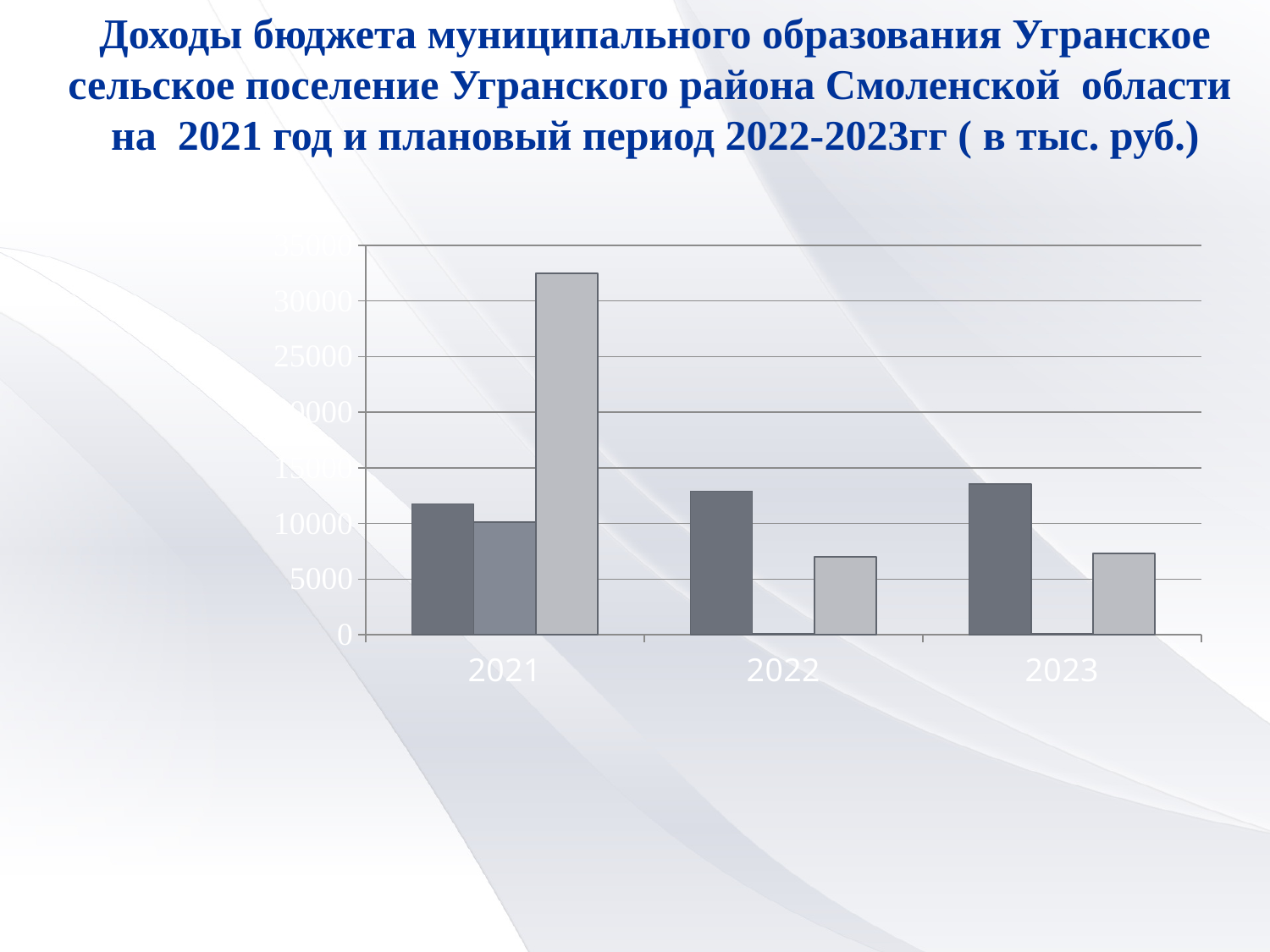
What kind of chart is shown on the slide? bar chart How many year categories are shown on the x axis of the chart? 3 Is the value of the first (dark grey) bar for 2021 greater or less than 10000? greater Which is larger for 2021: the first (dark grey) bar or the third (light grey) bar? the third (light grey) bar Is the value of the tallest bar for 2021 greater or less than 30000? greater Do the values of the first (dark grey) bars rise or fall from 2021 to 2023? rise Is the value of the third (light grey) bar for 2023 greater or less than 10000? less Which is larger for 2022: the first (dark grey) bar or the third (light grey) bar? the first (dark grey) bar In what units are the values in the chart expressed, according to the slide title? тыс. руб. Which year has the tallest bar in the chart? 2021